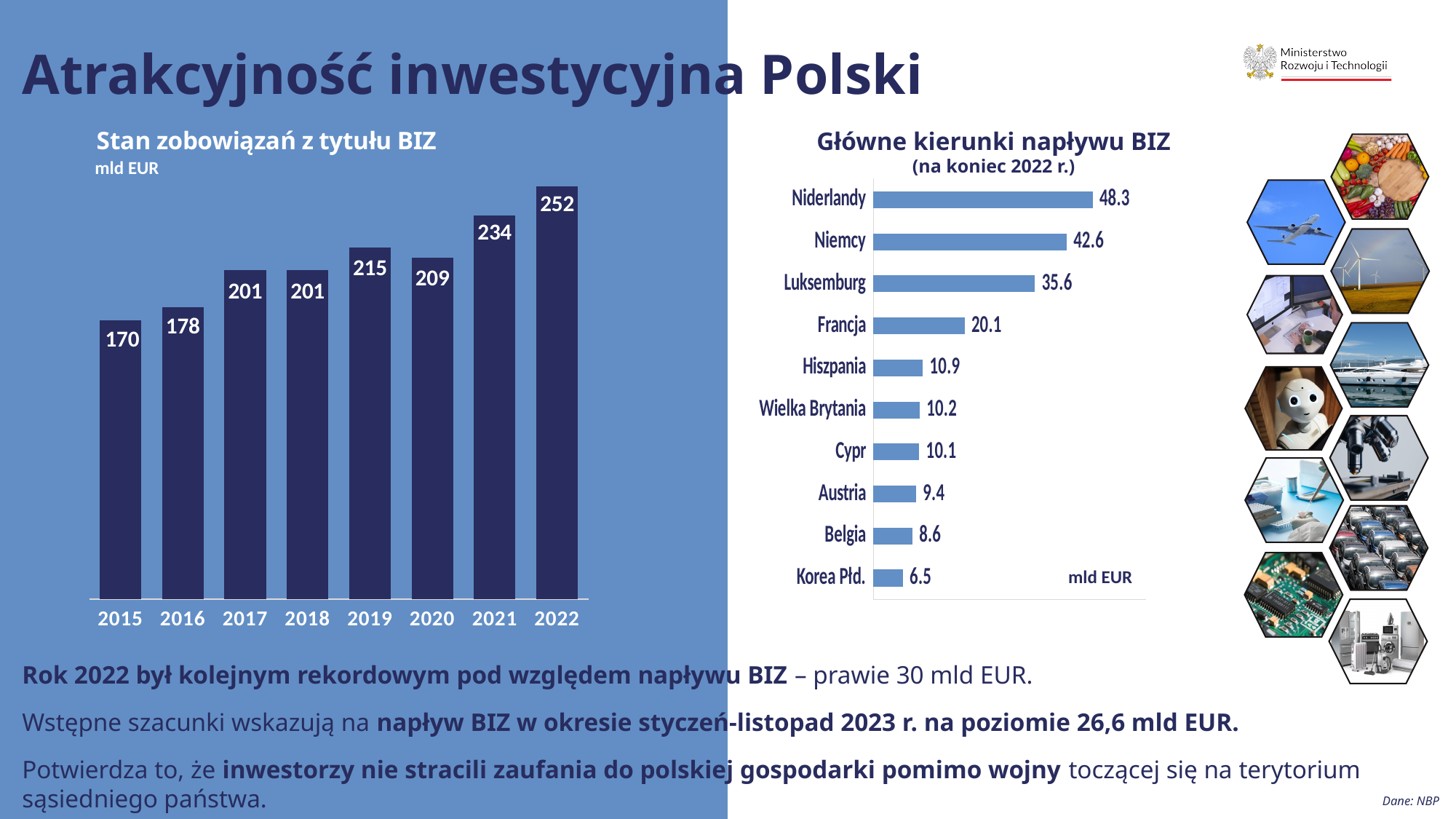
In the chart 'Główne kierunki napływu BIZ', which country has the lowest value? Korea Płd. In the chart 'Stan zobowiązań z tytułu BIZ', how many years are shown on the x axis? 8 In the chart 'Stan zobowiązań z tytułu BIZ', what is the value for 2019? 215 What kind of chart is 'Główne kierunki napływu BIZ'? bar chart In the chart 'Stan zobowiązań z tytułu BIZ', which year has the highest value? 2022 In the chart 'Stan zobowiązań z tytułu BIZ', what is the difference between the values for 2022 and 2021? 18 In the chart 'Główne kierunki napływu BIZ', what is the difference between the values for Niderlandy and Niemcy? 5.7 In the chart 'Główne kierunki napływu BIZ', which is larger, the value for Francja or the value for Hiszpania? Francja In the chart 'Główne kierunki napływu BIZ', which country has the highest value? Niderlandy In the chart 'Główne kierunki napływu BIZ', what is the value for Luksemburg? 35.6 In the chart 'Stan zobowiązań z tytułu BIZ', do the values generally rise or fall from 2015 to 2022? rise In the chart 'Stan zobowiązań z tytułu BIZ', which year has the lowest value? 2015